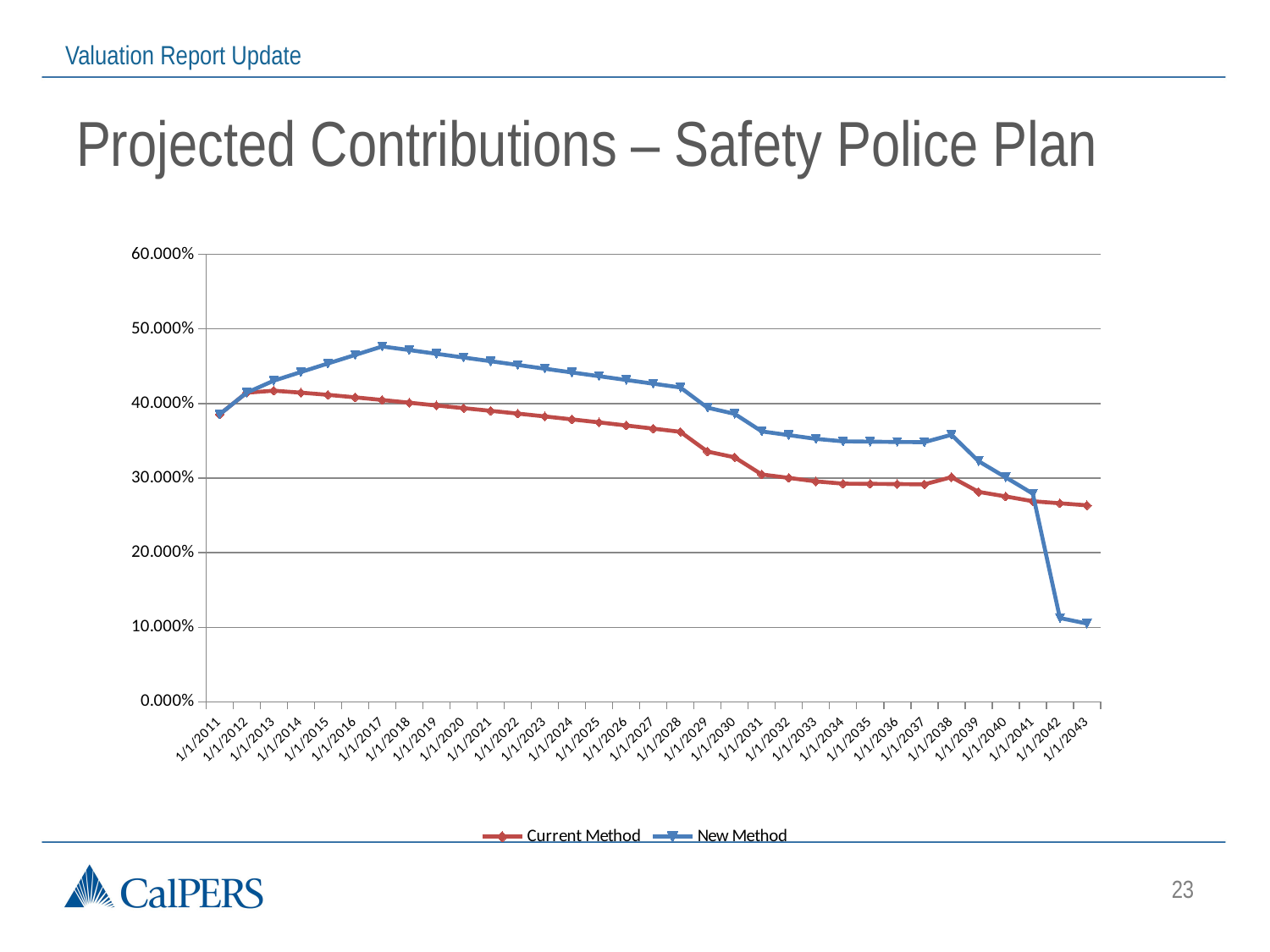
At 1/1/2030, which series has the larger value, Current Method or New Method? New Method At which date does the New Method series reach its highest value? 1/1/2017 Is the value for New Method at 1/1/2042 greater or less than 20.000%? less What are the two series named in the legend? Current Method and New Method Is the value for Current Method at 1/1/2043 greater or less than 30.000%? less At 1/1/2043, which series has the larger value, Current Method or New Method? Current Method How many series does the legend list? 2 Does the New Method series rise or fall overall from 1/1/2017 to 1/1/2043? Fall At which date does the New Method series reach its lowest value? 1/1/2043 Is the value for New Method at 1/1/2017 greater or less than 40.000%? greater How many dates are shown along the x axis? 33 What kind of chart is shown on the slide? Line chart